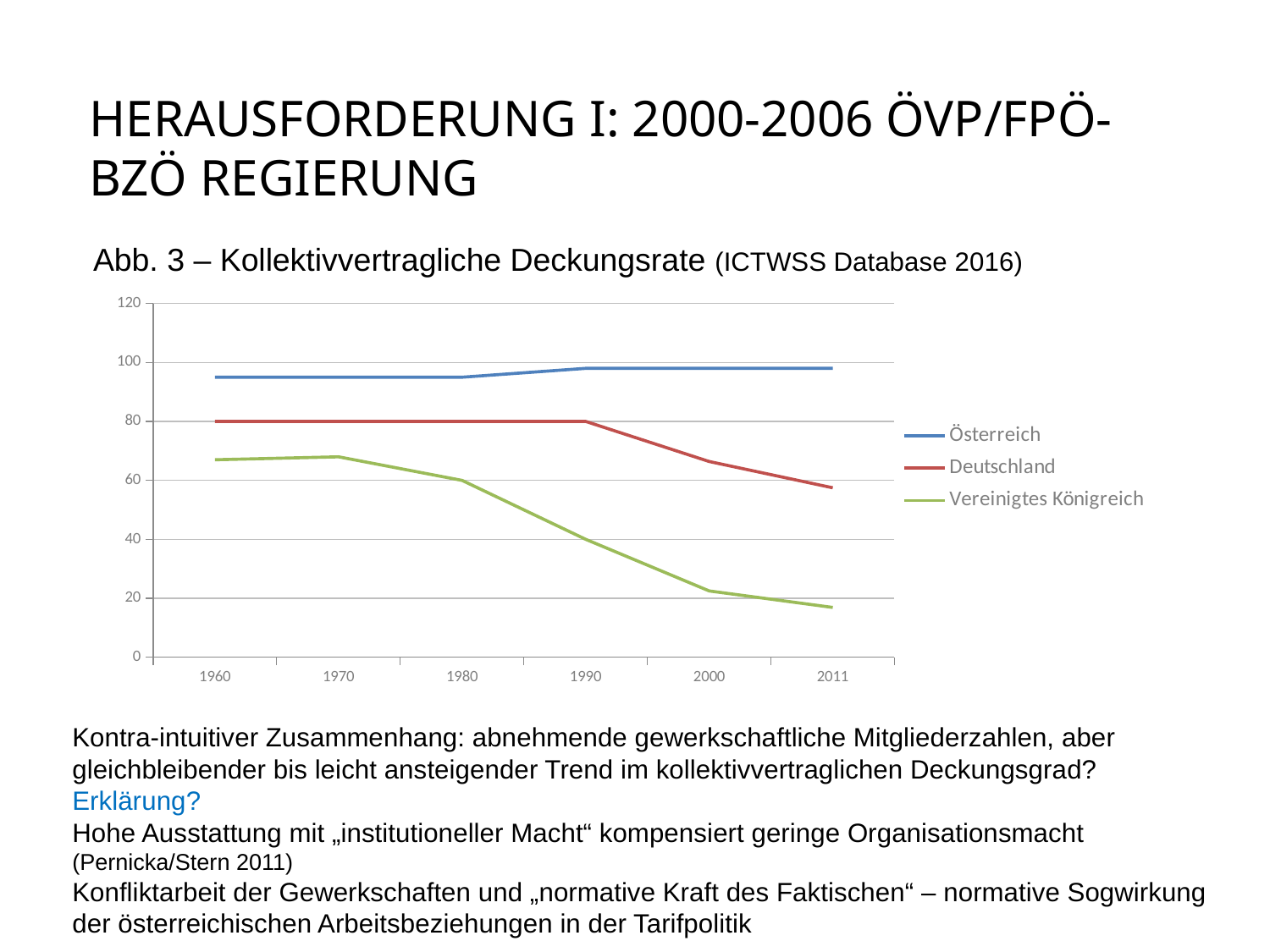
Does the value for Deutschland rise or fall between 1990 and 2011? fall How many series does the legend list? 3 In 1990, which is larger: the value for Deutschland or the value for Vereinigtes Königreich? Deutschland Which series has the highest value in 2011? Österreich What kind of chart is shown on the slide? line chart Which series is drawn in green? Vereinigtes Königreich Is the value for Vereinigtes Königreich in 2000 greater or less than 40? less Which series has the lowest value in 2011? Vereinigtes Königreich Does the value for Vereinigtes Königreich rise or fall between 1970 and 2011? fall Is the value for Österreich in 1960 greater or less than 80? greater How many years are marked along the x axis? 6 What is the value for Deutschland in 1980? 80